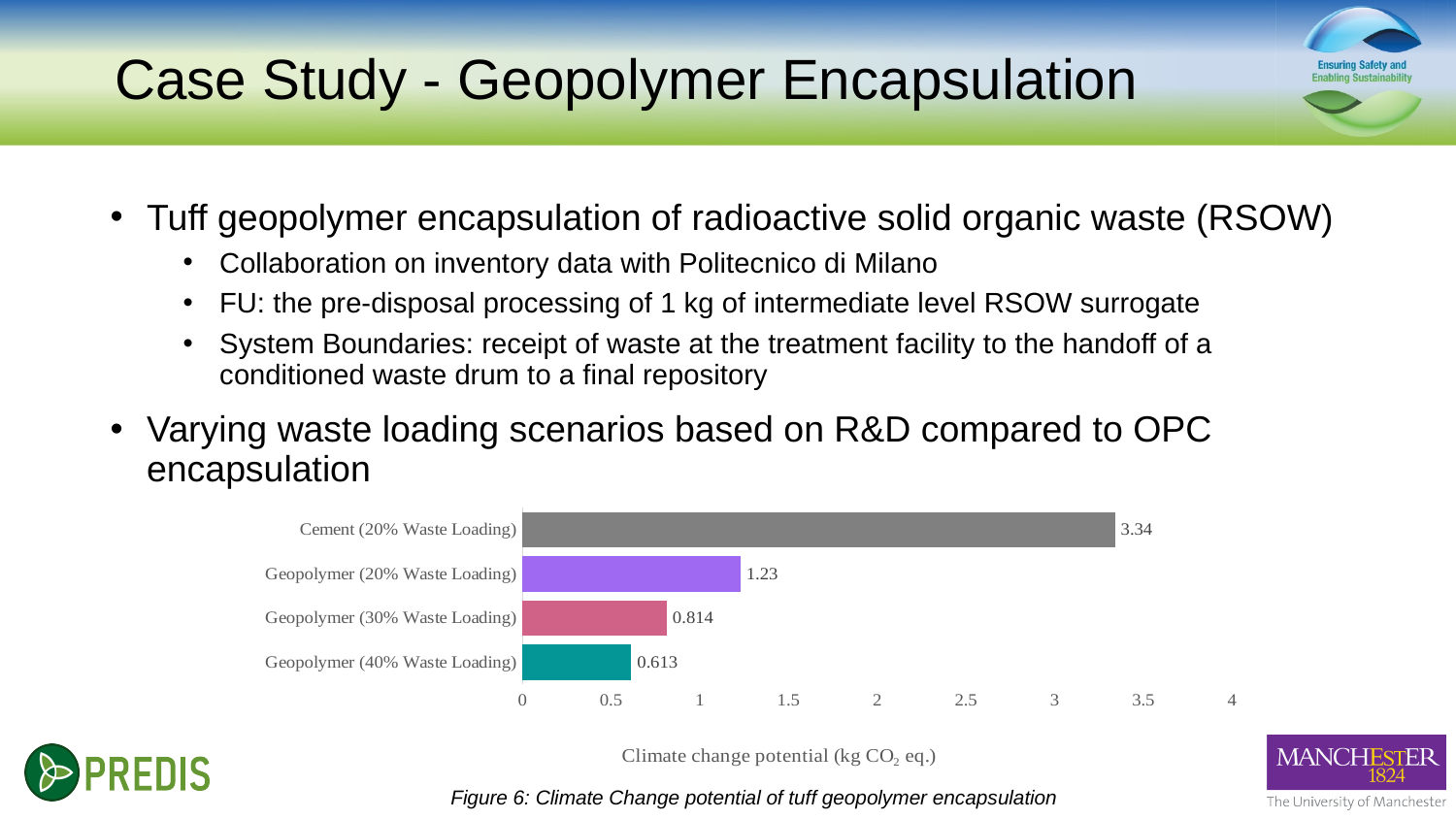
Which category has the highest climate change potential? Cement (20% Waste Loading) What is the climate change potential for Geopolymer (40% Waste Loading)? 0.613 What kind of chart is shown on the slide? Bar chart What is the difference in climate change potential between Geopolymer (30% Waste Loading) and Geopolymer (40% Waste Loading)? 0.201 What is the label of the x axis of the chart? Climate change potential (kg CO2 eq.) Is the value for Cement (20% Waste Loading) greater or less than 3? greater Which has a larger climate change potential, Geopolymer (20% Waste Loading) or Geopolymer (30% Waste Loading)? Geopolymer (20% Waste Loading) What is the difference in climate change potential between Cement (20% Waste Loading) and Geopolymer (20% Waste Loading)? 2.11 How many categories are shown in the chart? 4 What is the climate change potential for Cement (20% Waste Loading)? 3.34 What is the climate change potential for Geopolymer (30% Waste Loading)? 0.814 Which category has the lowest climate change potential? Geopolymer (40% Waste Loading)